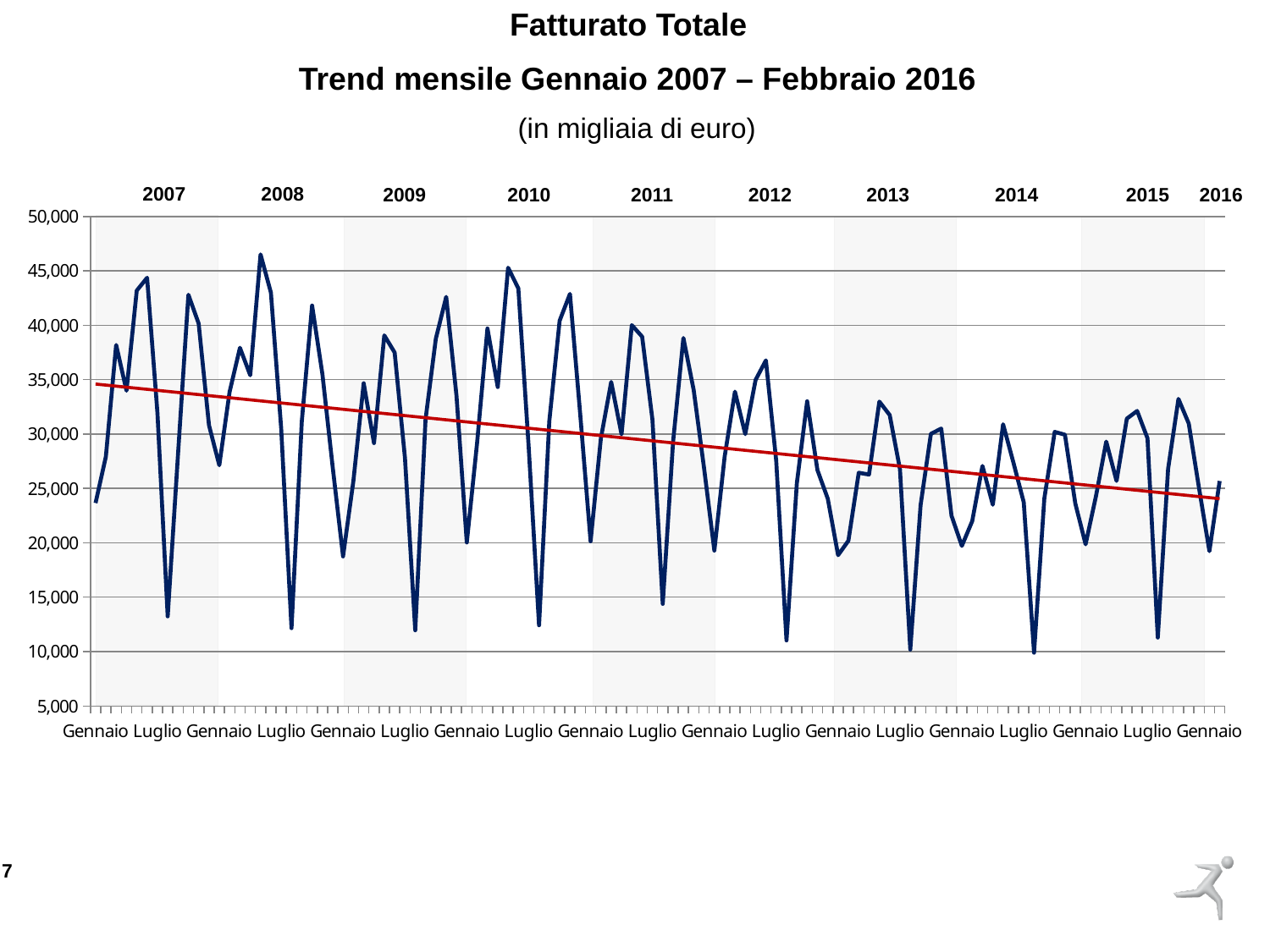
Does the red trend line rise or fall from 2007 to 2016? fall Is the lowest point in 2014 greater or less than 15,000? less Is the value of the red trend line at the start of 2007 greater or less than 30,000? greater In what unit are the values on the chart expressed? migliaia di euro How many years are labelled along the top of the chart? 10 What kind of chart is shown on the slide? line chart What is the highest value shown on the vertical axis? 50,000 Is the value for Gennaio 2007 greater or less than 30,000? less Which year contains the highest peak of the blue line, 2008 or 2015? 2008 What is the title of the chart on the slide? Fatturato Totale